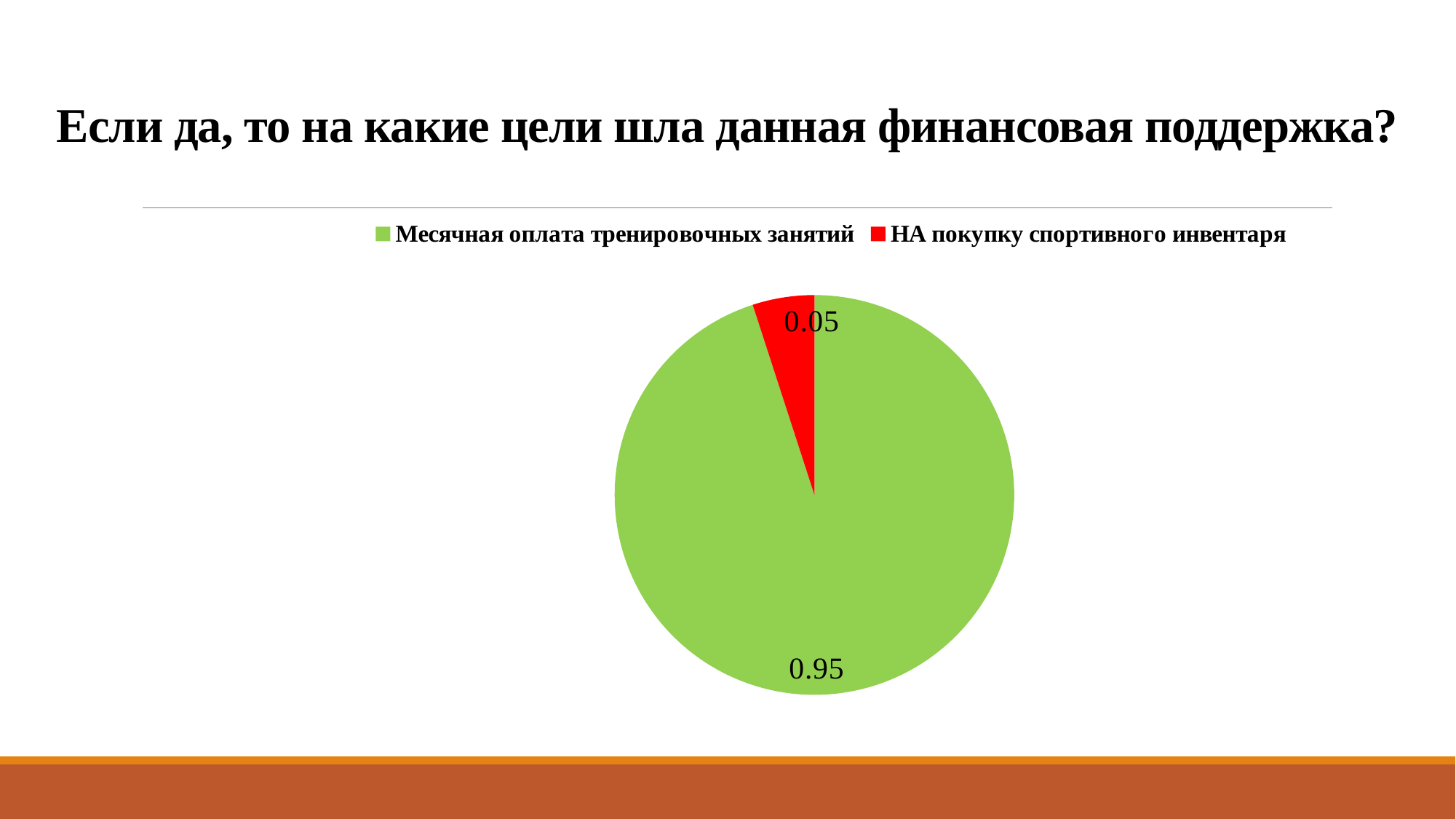
What colour is the slice for "НА покупку спортивного инвентаря"? red How many slices does the pie chart have? 2 What is the total of the two values shown on the pie chart? 1 What is the value for "НА покупку спортивного инвентаря"? 0.05 Which is larger: the value for "Месячная оплата тренировочных занятий" or for "НА покупку спортивного инвентаря"? Месячная оплата тренировочных занятий Which category has the smallest slice of the pie? НА покупку спортивного инвентаря What type of chart is shown on the slide? pie chart How many entries does the legend list? 2 What is the title of the slide containing the chart? Если да, то на какие цели шла данная финансовая поддержка? Which category has the largest slice of the pie? Месячная оплата тренировочных занятий What is the difference between the values for "Месячная оплата тренировочных занятий" and "НА покупку спортивного инвентаря"? 0.9 What is the value for "Месячная оплата тренировочных занятий"? 0.95